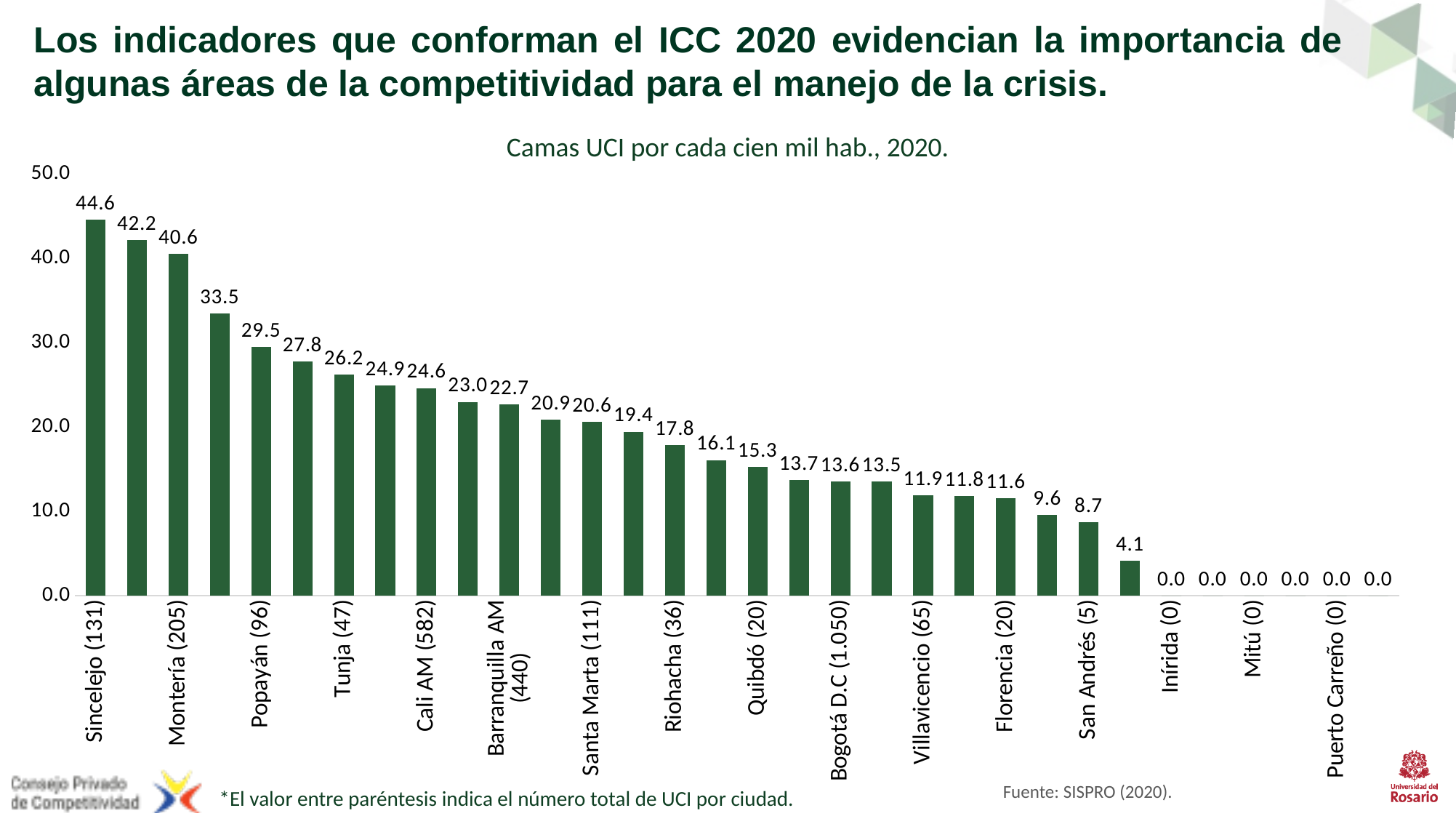
How many bars are plotted in the chart? 26 What is the difference between the values for Montería (205) and Popayán (96)? 11.1 How many cities show a value of 0.0? 6 Which city has the highest number of ICU beds per hundred thousand inhabitants? Sincelejo (131) Which has a larger value, Riohacha (36) or Quibdó (20)? Riohacha (36) What is the value for Bogotá D.C (1.050)? 13.6 What type of chart is shown on the slide? Bar chart What is the value for Sincelejo (131)? 44.6 What is the title of the chart? Camas UCI por cada cien mil hab., 2020. What is the value for San Andrés (5)? 8.7 Do the values rise or fall from left to right along the x axis? Fall What is the value for Cali AM (582)? 24.6